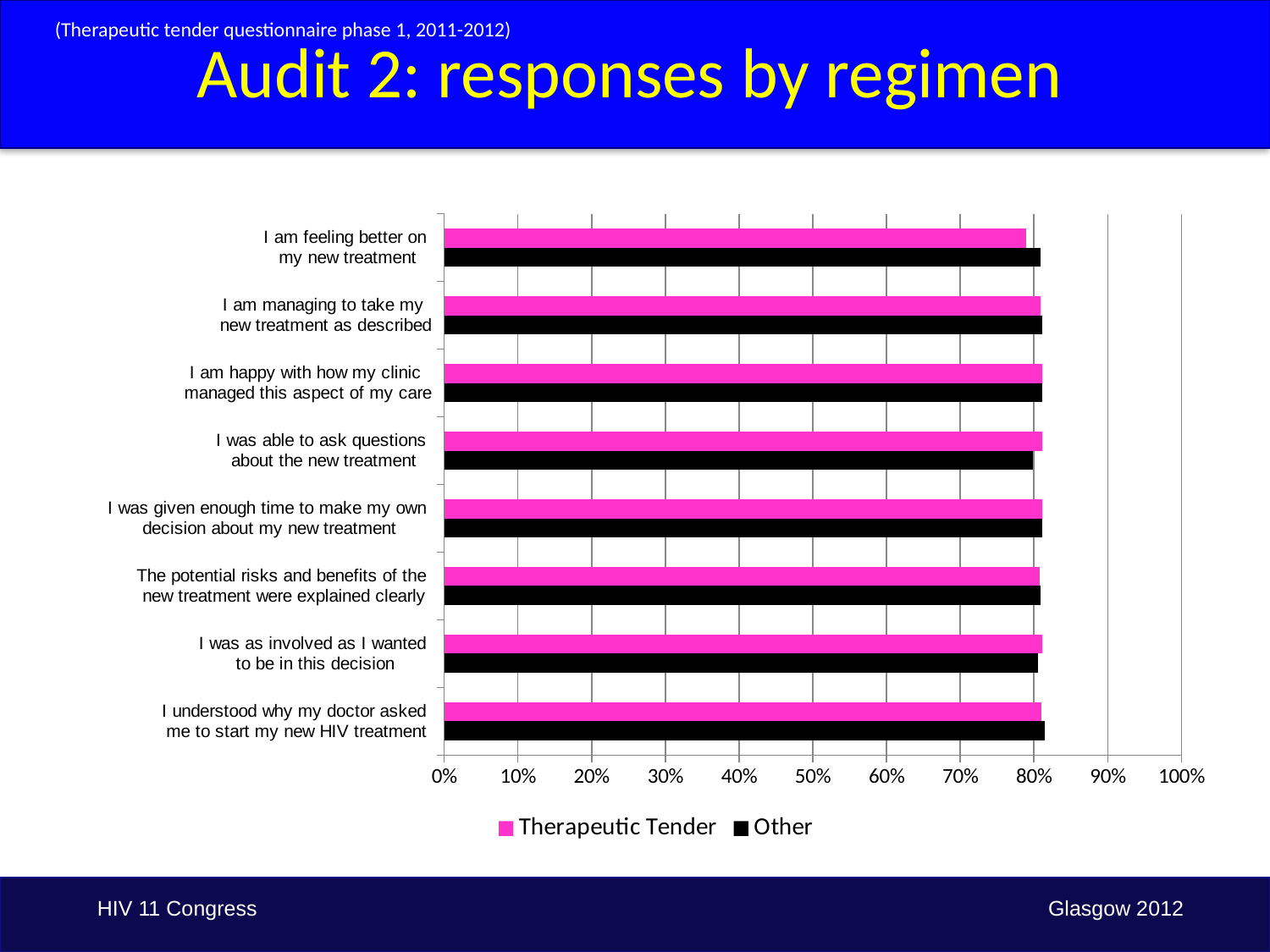
What is the highest value shown on the x axis? 100% Is the Therapeutic Tender value for 'I was able to ask questions about the new treatment' greater or less than 70%? greater What kind of chart is shown on the slide? bar chart Which series is shown in pink in the legend? Therapeutic Tender How many statements (categories) are plotted on the chart? 8 Is the Other value for 'I am managing to take my new treatment as described' greater or less than 90%? less Is the Therapeutic Tender value for 'I am feeling better on my new treatment' greater or less than 70%? greater How many series does the legend list? 2 Which series is shown in black in the legend? Other Which statement has the lowest Therapeutic Tender value? I am feeling better on my new treatment For 'I am feeling better on my new treatment', which series has the larger value, Therapeutic Tender or Other? Other